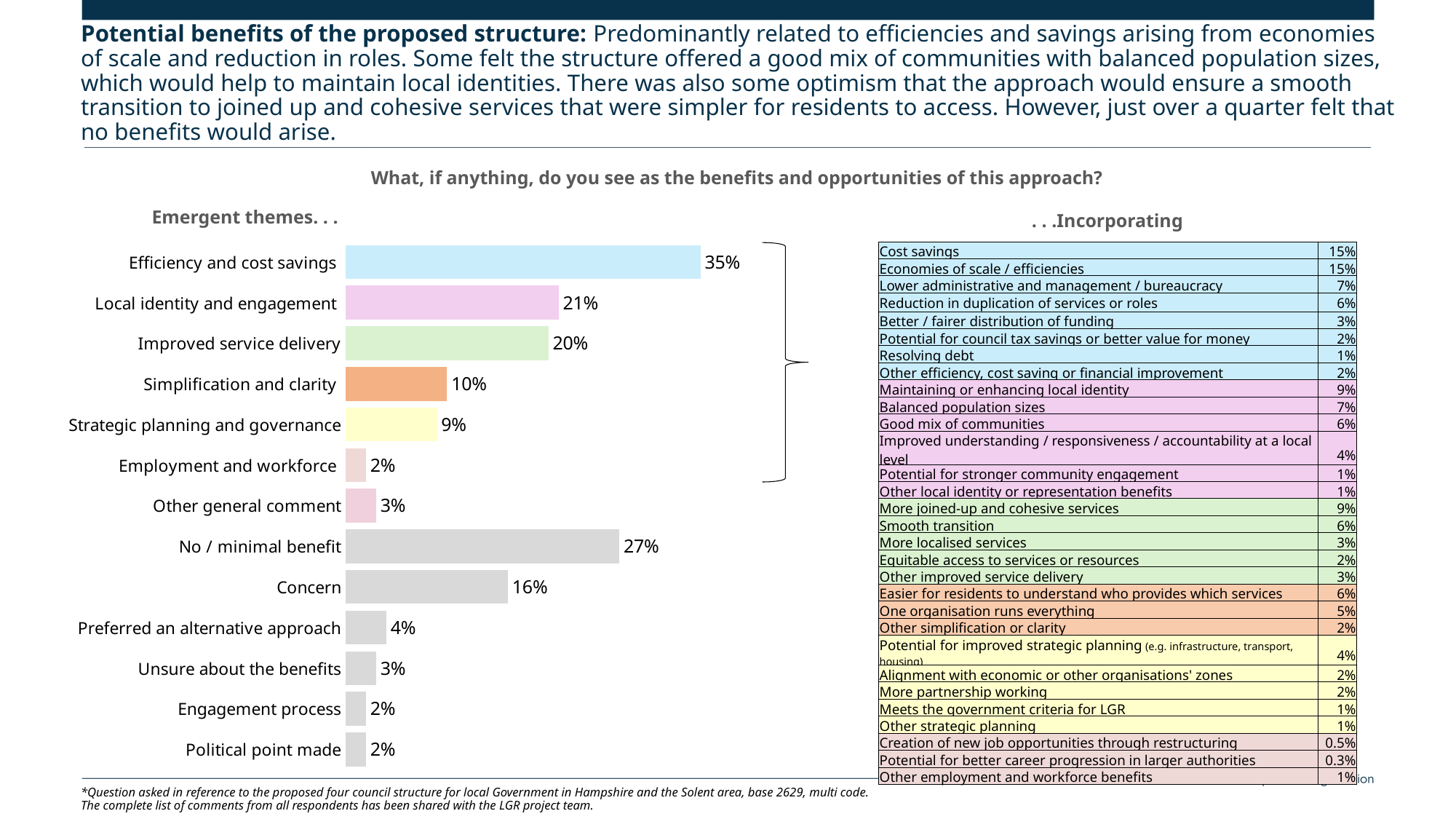
What is the value shown for No / minimal benefit? 27% What is the question text shown above the chart? What, if anything, do you see as the benefits and opportunities of this approach? What percentage of respondents mentioned Efficiency and cost savings? 35% What percentage is shown for Strategic planning and governance? 9% Which theme has the highest percentage in the bar chart? Efficiency and cost savings Which is larger: the value for Concern or the value for Simplification and clarity? Concern Which is larger: Improved service delivery or Strategic planning and governance? Improved service delivery How many themes (bars) are shown in the bar chart? 13 What is the difference between the values for Efficiency and cost savings and No / minimal benefit? 8% What is the difference between Local identity and engagement and Improved service delivery? 1% What is the value for Preferred an alternative approach? 4% What type of chart is used to show the emergent themes? Bar chart